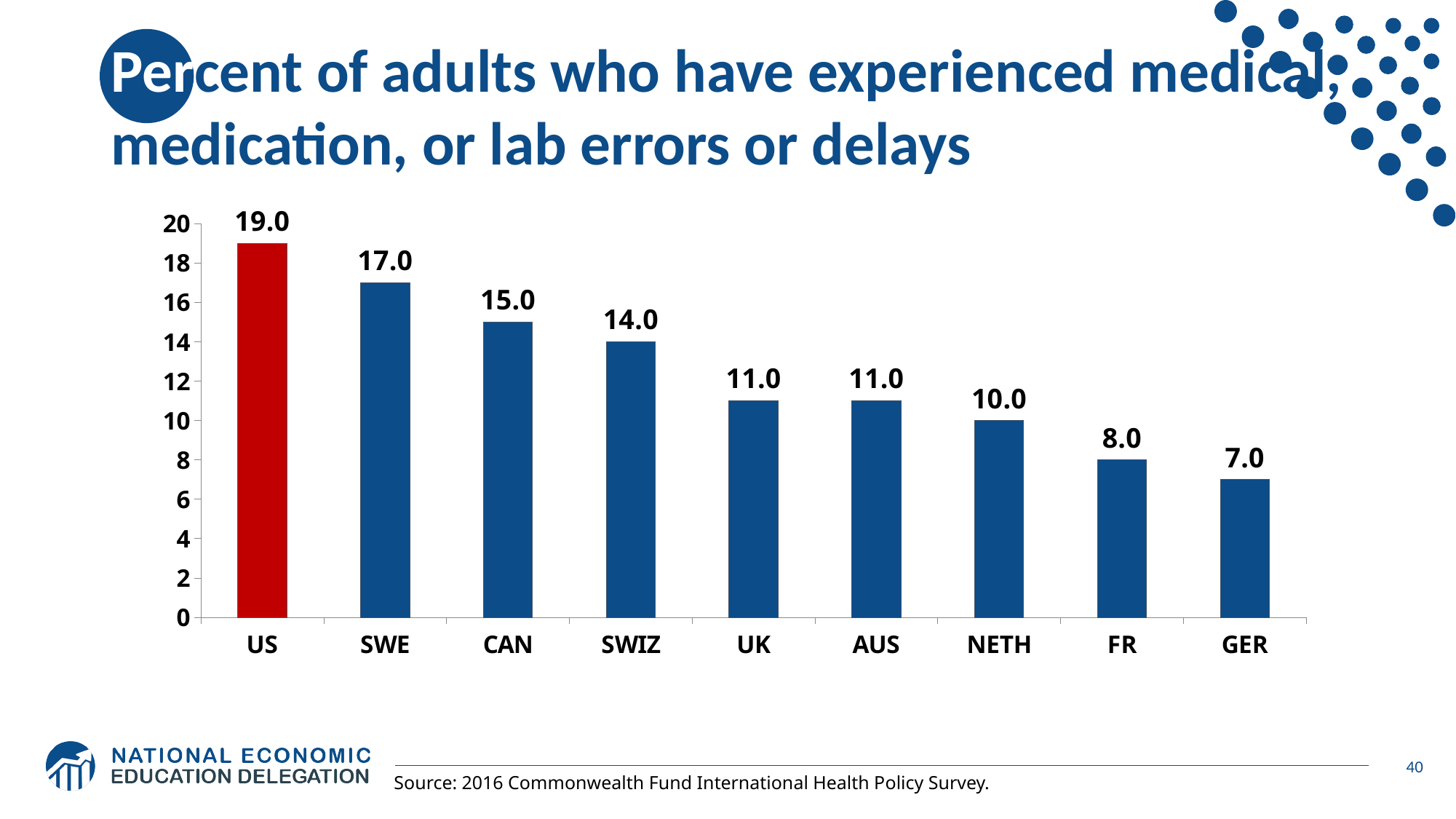
Which is larger, the value for CAN or the value for FR? CAN Do the values rise or fall from left to right across the chart? fall Which country has the lowest value? GER How many countries are shown on the chart? 9 What is the value for the US? 19.0 What kind of chart is shown on the slide? bar chart Which bar is coloured red rather than blue? US Which country has the highest value? US What is the value for NETH? 10.0 What is the difference between the values for the US and GER? 12.0 What is the value for SWIZ? 14.0 What is the difference between the values for SWE and CAN? 2.0